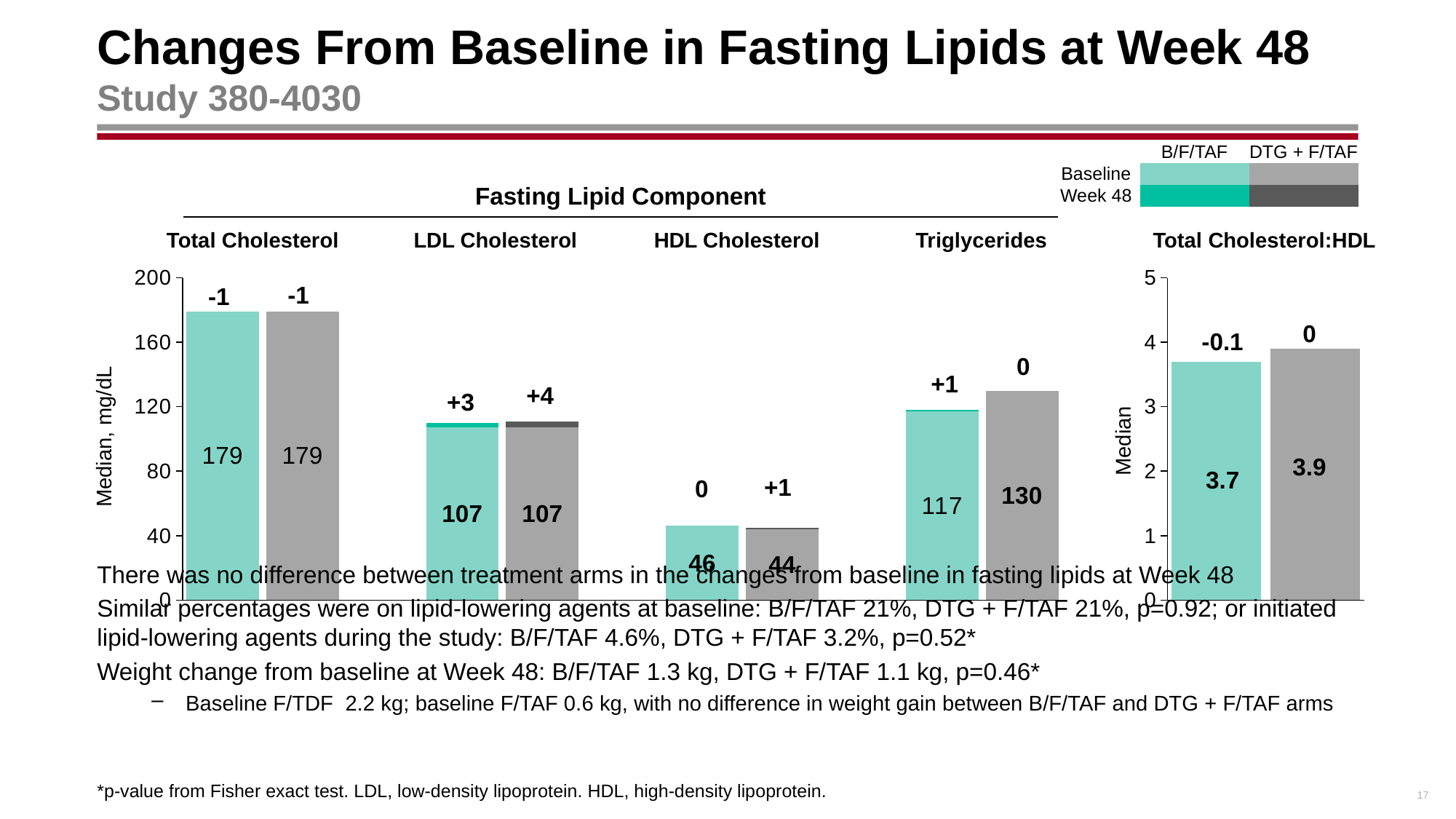
In the Fasting Lipid Component chart, is the median baseline LDL cholesterol for B/F/TAF greater or less than 120? less In the Fasting Lipid Component chart, which arm has the higher median baseline HDL cholesterol, B/F/TAF or DTG + F/TAF? B/F/TAF In the Fasting Lipid Component chart, what is the median baseline total cholesterol for the B/F/TAF arm? 179 In the Fasting Lipid Component chart, what is the median baseline triglycerides value for the DTG + F/TAF arm? 130 In the Fasting Lipid Component chart, what is the change from baseline in LDL cholesterol at Week 48 for the DTG + F/TAF arm? +4 In the Total Cholesterol:HDL chart, what is the median baseline ratio for the B/F/TAF arm? 3.7 What type of chart is used to show the fasting lipid components? Bar chart In the Total Cholesterol:HDL chart, what is the change from baseline at Week 48 for the B/F/TAF arm? -0.1 How many lipid components are shown in the Fasting Lipid Component chart? 4 In the Fasting Lipid Component chart, what is the median baseline HDL cholesterol for the DTG + F/TAF arm? 44 In the Fasting Lipid Component chart, which lipid component has the lowest median baseline values? HDL Cholesterol In the Fasting Lipid Component chart, what is the difference between the DTG + F/TAF and B/F/TAF median baseline triglycerides values? 13